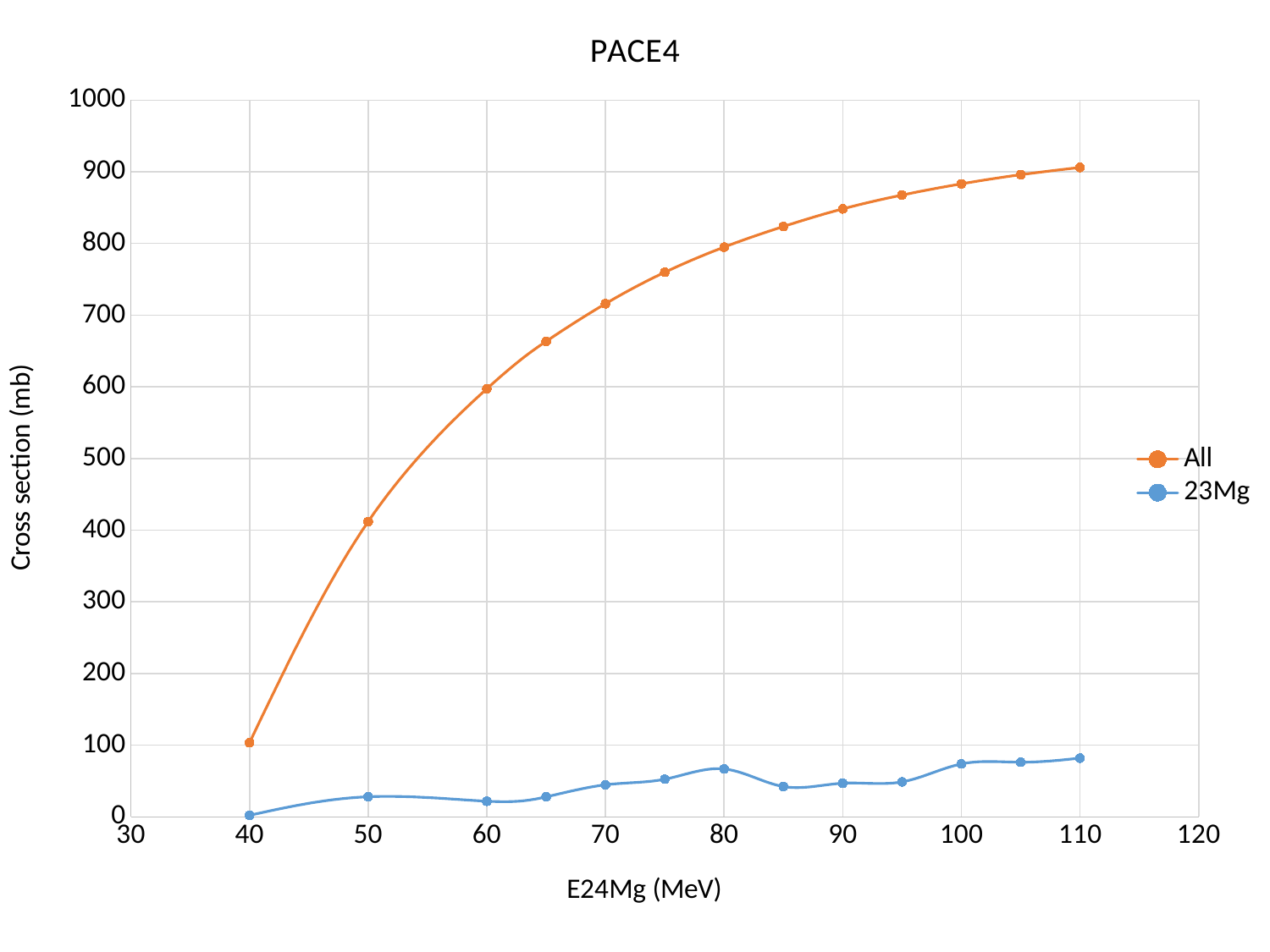
How many data points are plotted for the All series? 13 Is the value for All at 50 MeV greater or less than 400? greater Which series has the larger value at 80 MeV, All or 23Mg? All At which E24Mg value is the All series lowest? 40 How many series does the legend list? 2 What is the title of the chart? PACE4 Does the All series rise or fall as E24Mg increases from 40 to 110 MeV? rise At which E24Mg value is the All series highest? 110 What kind of chart is shown on the slide? line chart What is the label of the y axis? Cross section (mb) At which E24Mg value is the 23Mg series lowest? 40